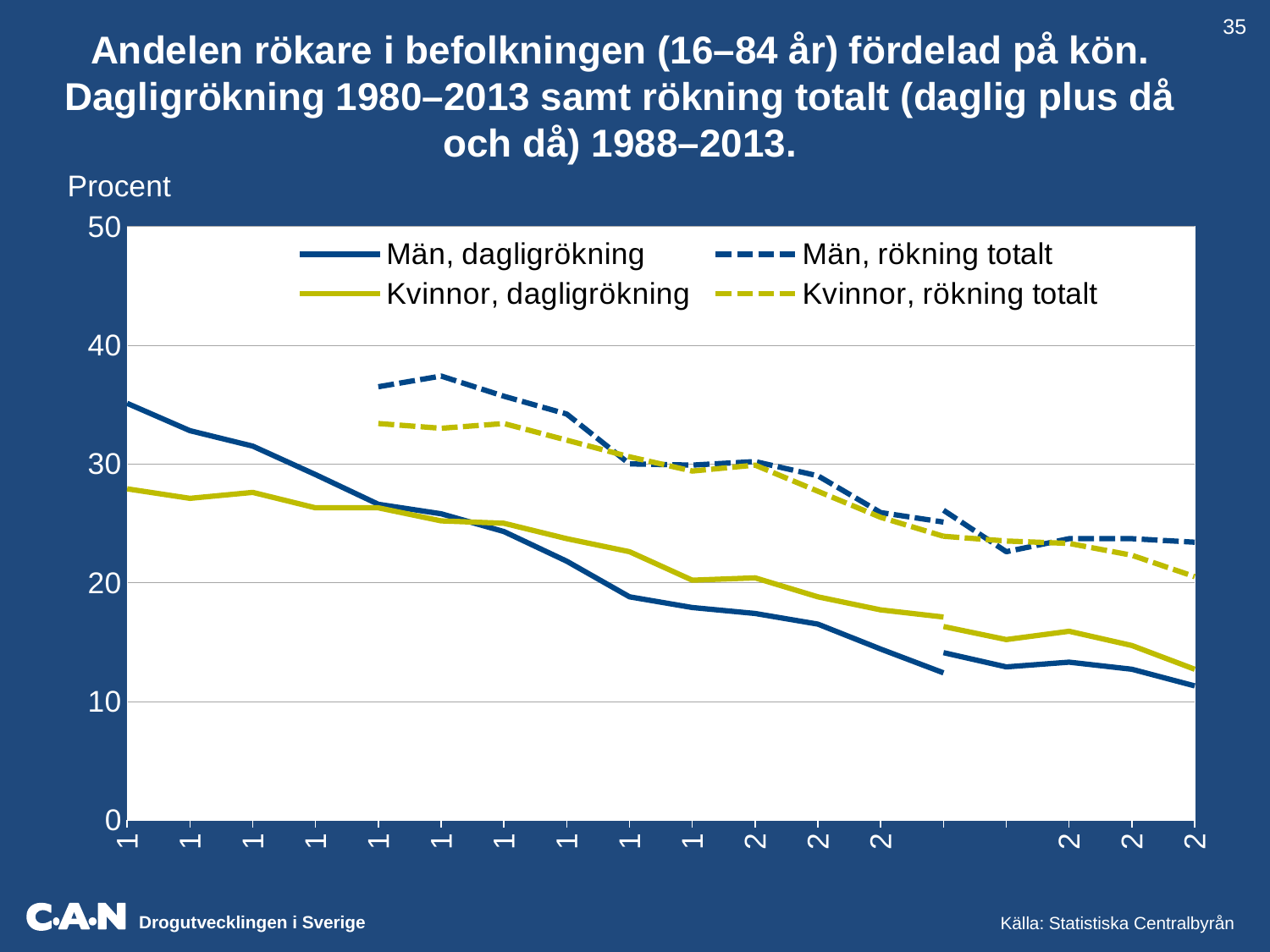
How many series does the legend list? 4 Is the final value of the Kvinnor, rökning totalt line greater or less than 30? less What label is shown on the vertical axis of the chart? Procent At the left end of the chart, which is higher: Män, dagligrökning or Kvinnor, dagligrökning? Män, dagligrökning Is the starting value of the Män, dagligrökning line greater or less than 30? greater What kind of chart is shown on the slide? line chart Which two series are drawn with dashed lines? Män, rökning totalt and Kvinnor, rökning totalt Do the values for Män, dagligrökning rise or fall along the x axis? fall Which series reaches the highest value anywhere on the chart? Män, rökning totalt Is the final value of the Män, dagligrökning line greater or less than 20? less At the right end of the chart, which is higher: Män, rökning totalt or Kvinnor, rökning totalt? Män, rökning totalt Do the values for Kvinnor, dagligrökning rise or fall along the x axis? fall